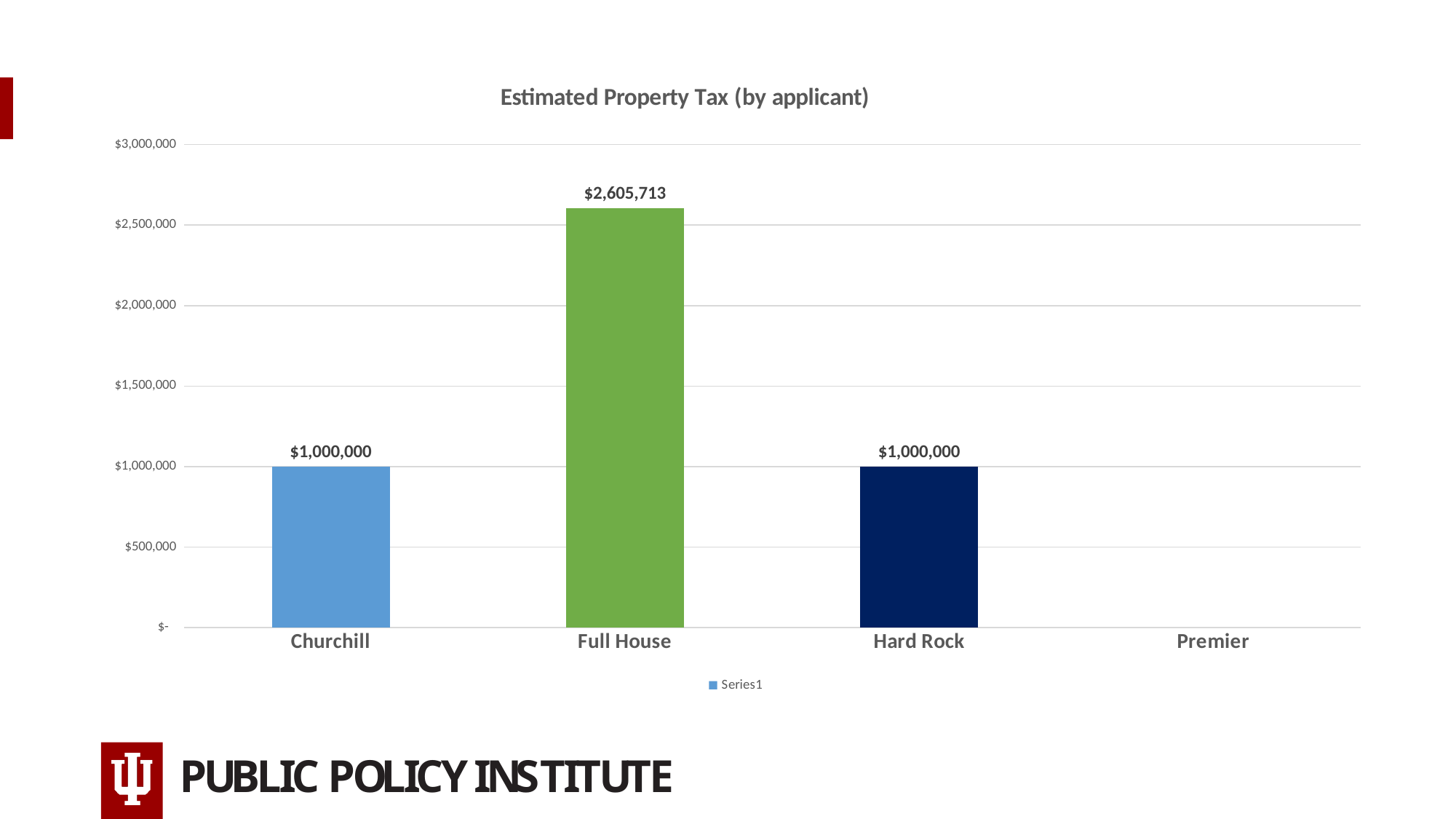
Which applicant has the highest estimated property tax? Full House How many series does the legend list? 1 Is the value for Churchill greater or less than $1,500,000? less What is the title of the chart? Estimated Property Tax (by applicant) What is the estimated property tax for Churchill? $1,000,000 What is the estimated property tax for Hard Rock? $1,000,000 Which has a larger estimated property tax, Full House or Hard Rock? Full House What is the estimated property tax for Full House? $2,605,713 What kind of chart is shown on the slide? Bar chart Is the value for Full House greater or less than $2,500,000? greater What is the difference between the estimated property tax for Full House and Churchill? $1,605,713 How many applicants are listed on the x axis? 4